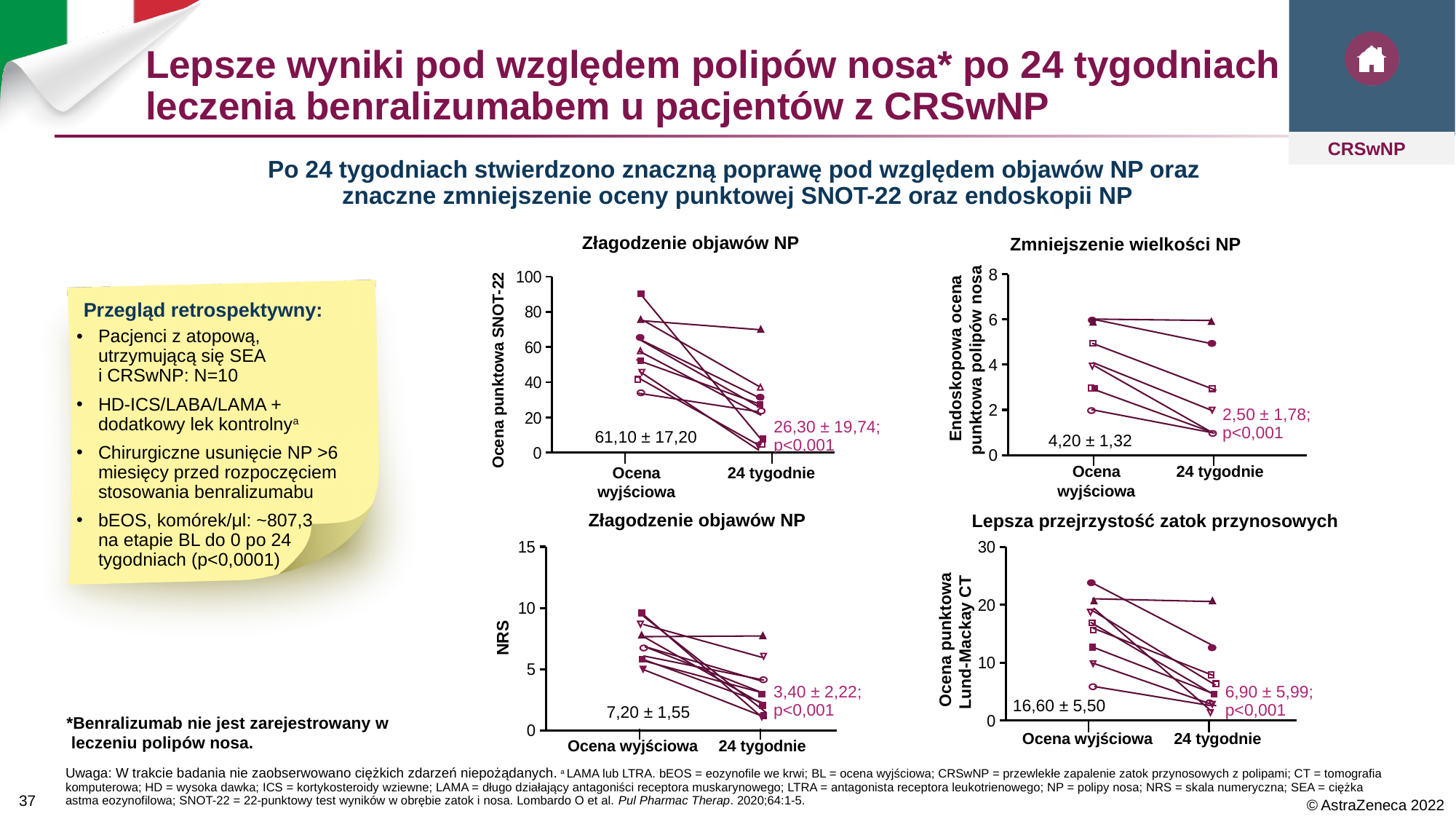
On the chart titled 'Zmniejszenie wielkości NP', which time point has the larger mean score, Ocena wyjściowa or 24 tygodnie? Ocena wyjściowa On the top-left chart (SNOT-22), what is the mean score at baseline (Ocena wyjściowa)? 61,10 ± 17,20 On the top-left chart (SNOT-22), by how much does the mean score decrease from baseline to 24 tygodnie? 34,80 How many time points are shown on the x axis of the chart titled 'Lepsza przejrzystość zatok przynosowych'? 2 On the chart titled 'Lepsza przejrzystość zatok przynosowych', what is the mean Lund-Mackay CT score after 24 tygodnie? 6,90 ± 5,99 What kind of chart is the top-left chart titled 'Złagodzenie objawów NP'? line chart On the chart titled 'Zmniejszenie wielkości NP', what is the mean endoscopic polyp score at baseline? 4,20 ± 1,32 On the chart titled 'Zmniejszenie wielkości NP', what is the mean score after 24 tygodnie? 2,50 ± 1,78 On the top-left chart (SNOT-22), what is the mean score after 24 tygodnie? 26,30 ± 19,74 On the bottom-left chart (NRS), do the mean values rise or fall from baseline to 24 tygodnie? fall On the bottom-left chart (NRS), what is the mean score at baseline? 7,20 ± 1,55 On the chart titled 'Lepsza przejrzystość zatok przynosowych', what is the difference between the mean baseline score and the mean score at 24 tygodnie? 9,70